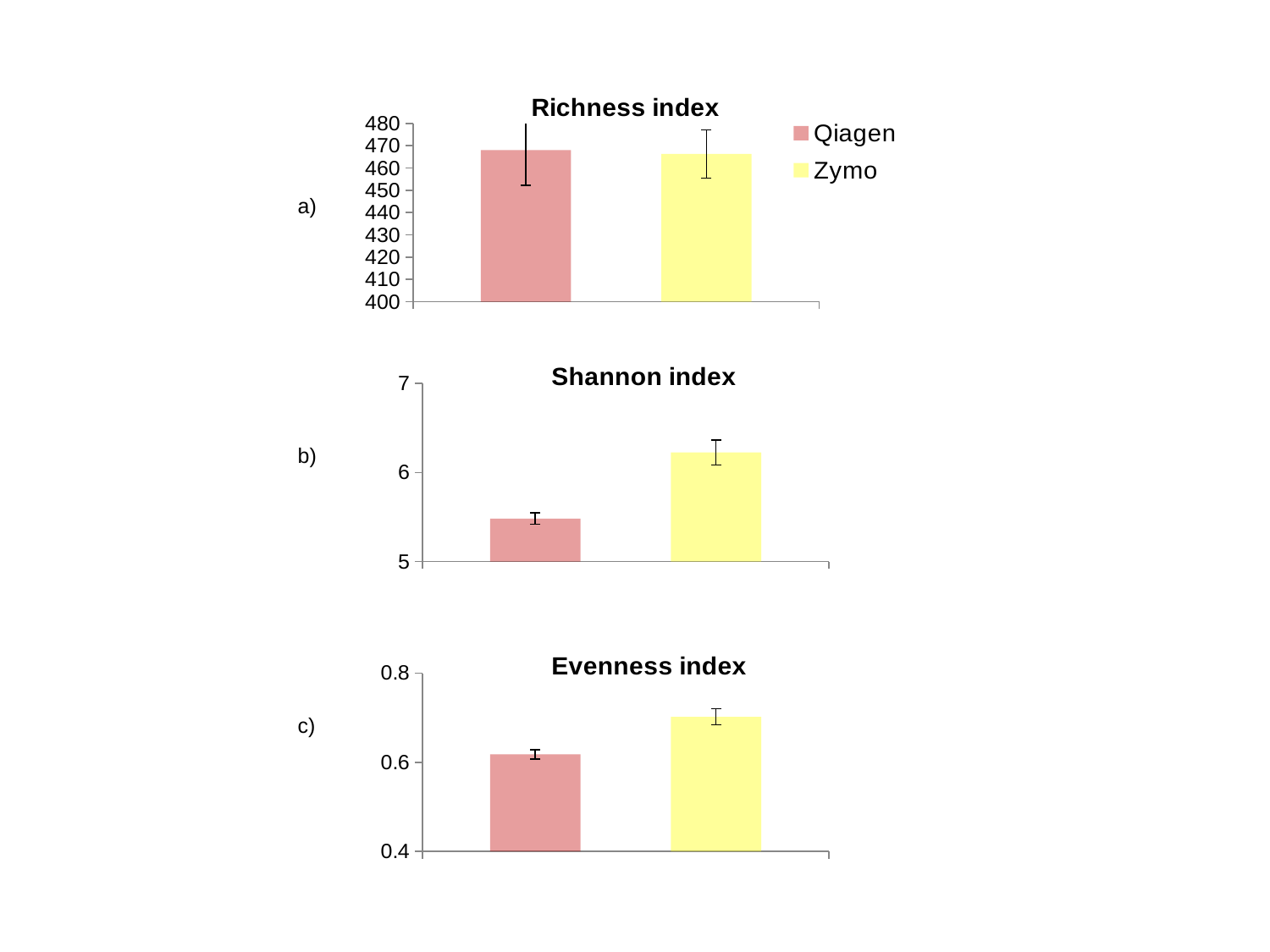
What kind of chart is the Shannon index chart? bar chart In the Richness index chart, is the value for Qiagen greater or less than 460? greater In the Evenness index chart, is the value for Qiagen greater or less than 0.6? greater In the Evenness index chart, which series has the lower value, Qiagen or Zymo? Qiagen How many series does the legend on the Richness index chart list? 2 Which series is shown in yellow in the Richness index chart's legend? Zymo In the Evenness index chart, is the value for Zymo greater or less than 0.8? less In the Shannon index chart, which series has the higher value, Qiagen or Zymo? Zymo How many bars are plotted in the Evenness index chart? 2 What is the title of the chart labelled c)? Evenness index